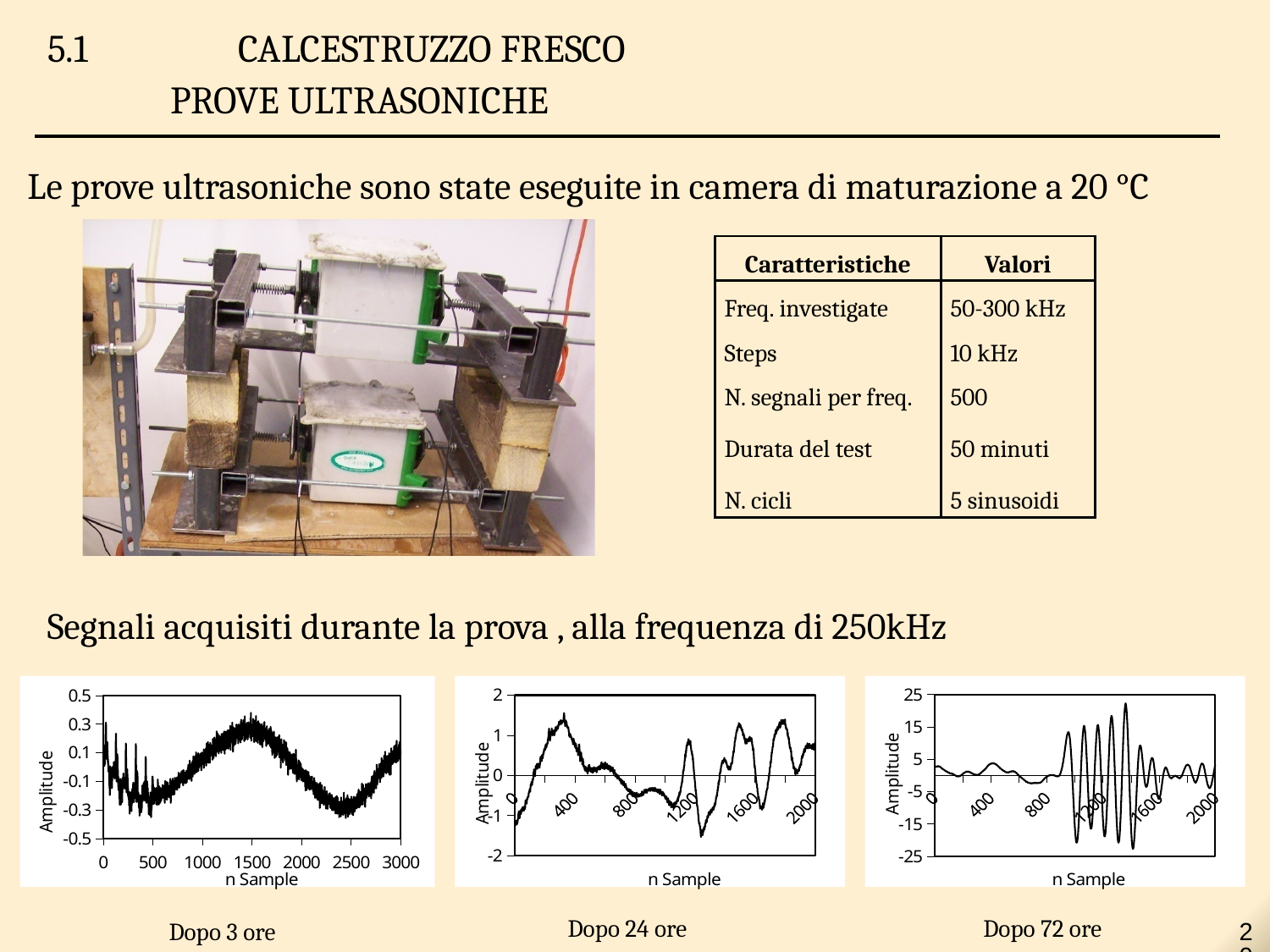
On the 'Dopo 72 ore' chart, is the highest peak amplitude greater or less than 15? greater On the 'Dopo 3 ore' chart, what is the highest tick value shown on the x axis? 3000 What kind of chart is the 'Dopo 72 ore' chart on the right? line chart On the 'Dopo 72 ore' chart, is the lowest trough amplitude greater or less than -15? less What kind of chart is the 'Dopo 3 ore' chart on the left? line chart Which of the three signal charts has the largest amplitude axis range: 'Dopo 3 ore', 'Dopo 24 ore' or 'Dopo 72 ore'? Dopo 72 ore How many signal charts are shown at the bottom of the slide? 3 On the 'Dopo 72 ore' chart, what is the highest tick value shown on the y axis? 25 On the 'Dopo 3 ore' chart, is the maximum amplitude greater or less than 0.5? less On the 'Dopo 24 ore' chart, what is the label of the x axis? n Sample On the 'Dopo 3 ore' chart, what is the label of the y axis? Amplitude